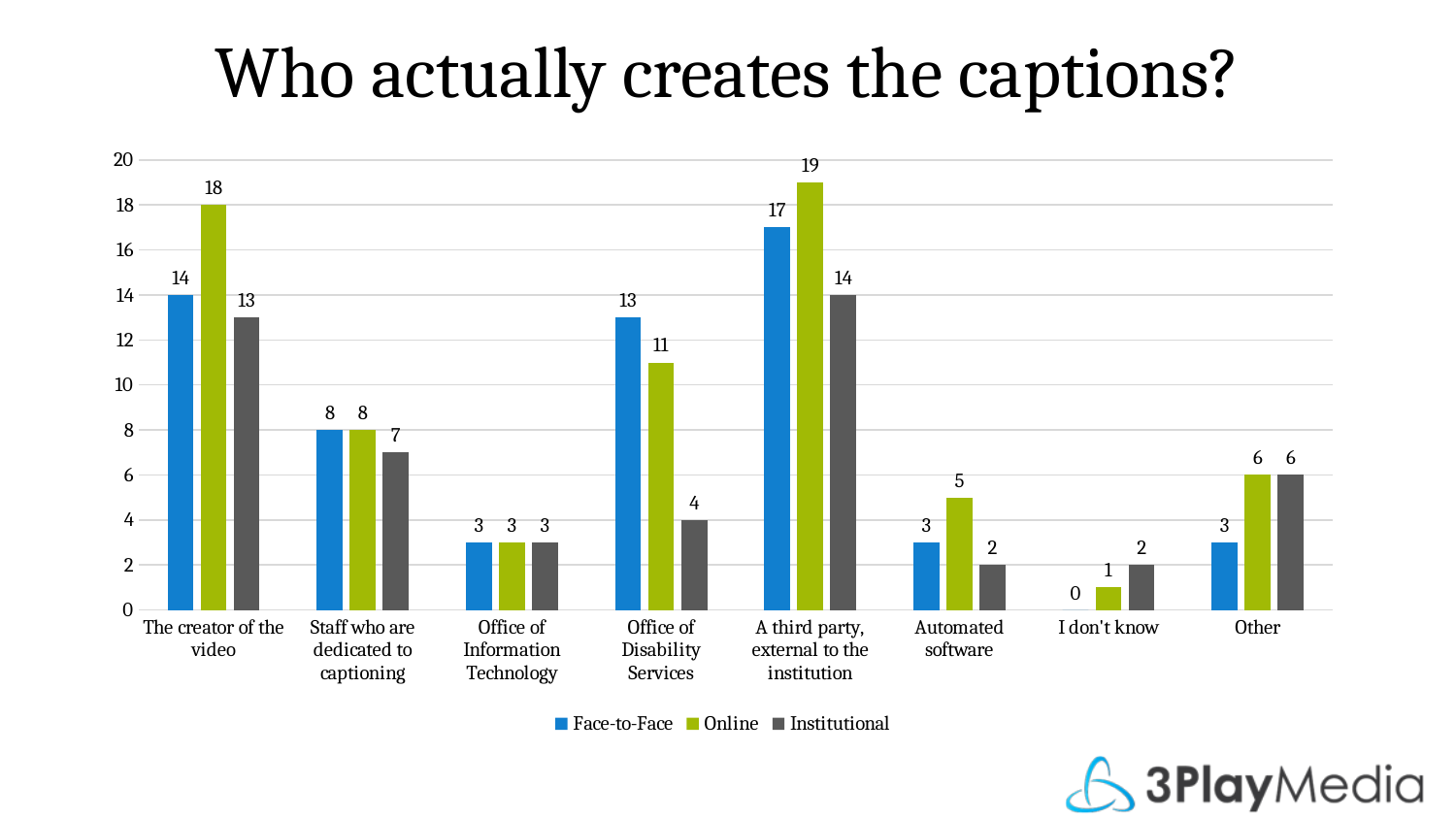
Which category has the lowest Face-to-Face value? I don't know Which category has the highest Online value? A third party, external to the institution What is the Face-to-Face value for "The creator of the video"? 14 How many series does the legend list? 3 What kind of chart is shown on the slide? Bar chart What is the difference between the Online and Institutional values for "The creator of the video"? 5 What is the Institutional value for "Office of Disability Services"? 4 What is the Online value for "A third party, external to the institution"? 19 Which is larger for "Automated software": the Online value or the Institutional value? Online How many categories are shown on the x axis? 8 What is the title of the chart? Who actually creates the captions? Which series is shown in green in the legend? Online